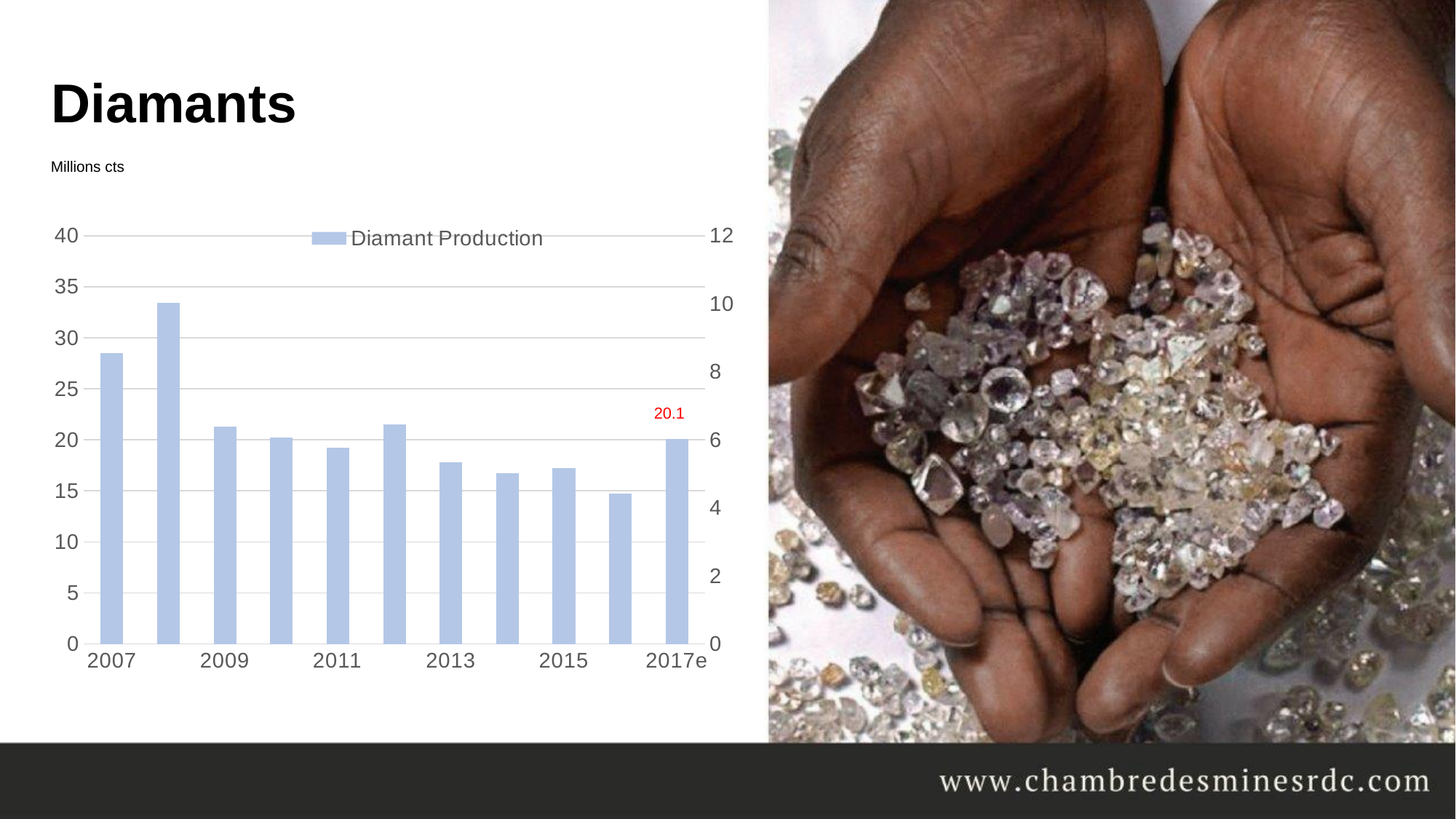
What is the value for 2017e in the Diamant Production chart? 20.1 What kind of chart is shown on the slide? bar chart Which year has the highest diamond production bar? 2008 How many series does the legend list? 1 Which is larger, the bar for 2007 or the bar for 2009? 2007 Is the value for 2008 greater or less than 30? greater Is the value for 2014 greater or less than 20? less How many bars (years) are shown in the chart? 11 Is the value for 2007 greater or less than 25? greater What is the name of the series shown in the legend? Diamant Production Which year has the lowest diamond production bar? 2016